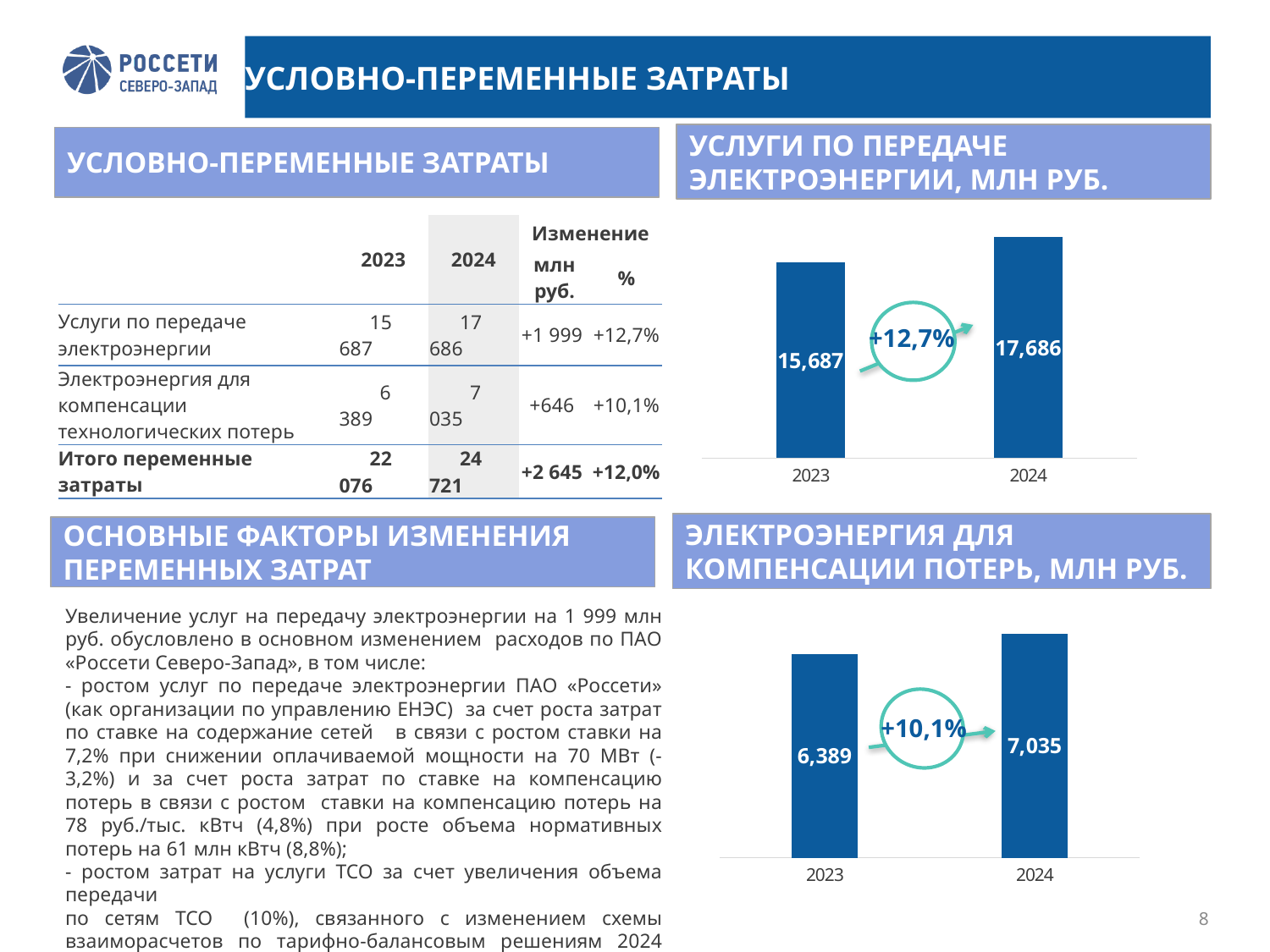
In the chart 'УСЛУГИ ПО ПЕРЕДАЧЕ ЭЛЕКТРОЭНЕРГИИ, МЛН РУБ.', what is the difference between the 2024 and 2023 values? 1,999 In the chart 'ЭЛЕКТРОЭНЕРГИЯ ДЛЯ КОМПЕНСАЦИИ ПОТЕРЬ, МЛН РУБ.', what is the difference between the 2024 and 2023 values? 646 In the chart 'ЭЛЕКТРОЭНЕРГИЯ ДЛЯ КОМПЕНСАЦИИ ПОТЕРЬ, МЛН РУБ.', which year has the lower value? 2023 In the chart 'ЭЛЕКТРОЭНЕРГИЯ ДЛЯ КОМПЕНСАЦИИ ПОТЕРЬ, МЛН РУБ.', what is the value for 2024? 7,035 In the chart 'УСЛУГИ ПО ПЕРЕДАЧЕ ЭЛЕКТРОЭНЕРГИИ, МЛН РУБ.', what percentage change is shown between 2023 and 2024? +12,7% What type of chart is 'ЭЛЕКТРОЭНЕРГИЯ ДЛЯ КОМПЕНСАЦИИ ПОТЕРЬ, МЛН РУБ.'? Bar chart In the chart 'УСЛУГИ ПО ПЕРЕДАЧЕ ЭЛЕКТРОЭНЕРГИИ, МЛН РУБ.', what is the value for 2023? 15,687 In the chart 'УСЛУГИ ПО ПЕРЕДАЧЕ ЭЛЕКТРОЭНЕРГИИ, МЛН РУБ.', what is the value for 2024? 17,686 In the chart 'ЭЛЕКТРОЭНЕРГИЯ ДЛЯ КОМПЕНСАЦИИ ПОТЕРЬ, МЛН РУБ.', what percentage change is shown between 2023 and 2024? +10,1% In the chart 'УСЛУГИ ПО ПЕРЕДАЧЕ ЭЛЕКТРОЭНЕРГИИ, МЛН РУБ.', which year has the higher value? 2024 In the chart 'ЭЛЕКТРОЭНЕРГИЯ ДЛЯ КОМПЕНСАЦИИ ПОТЕРЬ, МЛН РУБ.', what is the value for 2023? 6,389 In the chart 'УСЛУГИ ПО ПЕРЕДАЧЕ ЭЛЕКТРОЭНЕРГИИ, МЛН РУБ.', how many years are shown on the x axis? 2